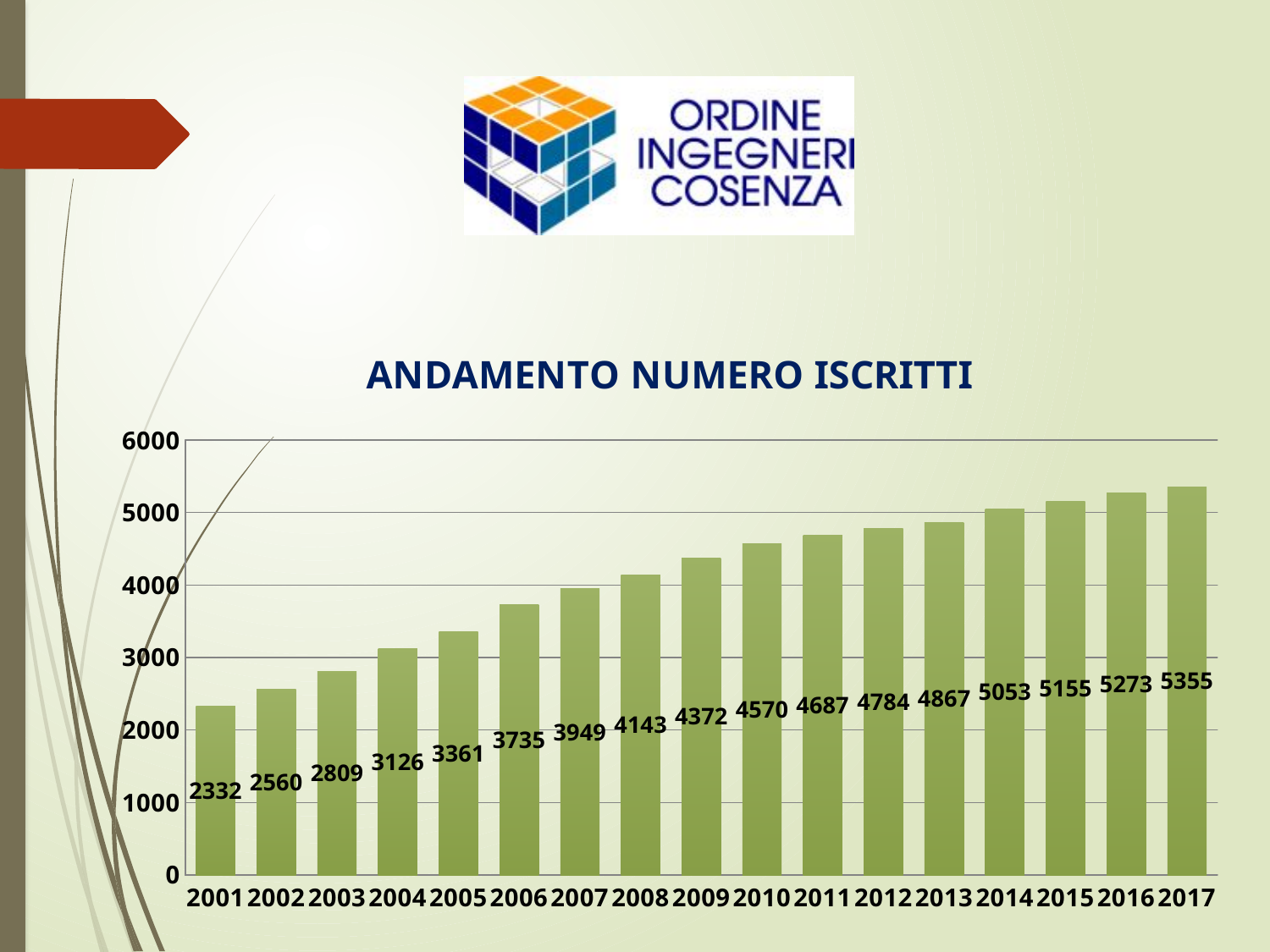
Is the value for 2014 greater or less than 5000? greater How many years are shown on the x axis? 17 What is the value for 2001? 2332 Which is larger, the value for 2008 or the value for 2012? 2012 Which year has the highest value? 2017 Do the values rise or fall from 2001 to 2017? rise Which year has the lowest value? 2001 What kind of chart is this? bar chart What is the value for 2010? 4570 What is the difference between the values for 2017 and 2001? 3023 What is the difference between the values for 2006 and 2005? 374 What is the value for 2017? 5355